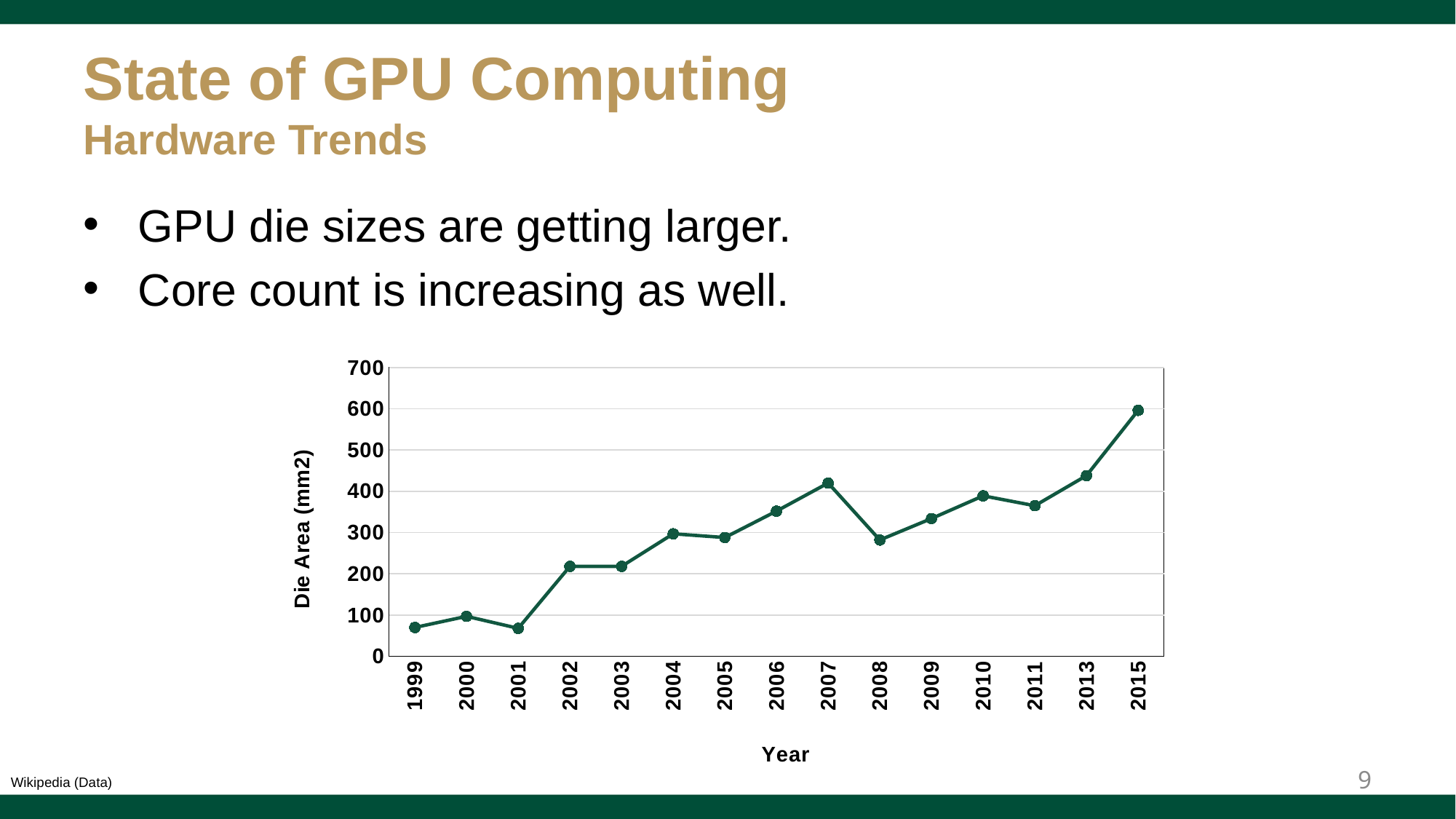
How many years are plotted on the x axis of the chart? 15 Is the die area for 2015 greater or less than 500? greater Which year has the highest die area in the chart? 2015 What kind of chart is shown on the slide? line chart Which year has the larger die area, 2007 or 2008? 2007 Is the die area for 2008 greater or less than 300? less Overall, does the die area rise or fall from 1999 to 2015? rise Is the die area for 2007 greater or less than 400? greater What is the label of the vertical axis of the chart? Die Area (mm2) Which year has the larger die area, 2001 or 2002? 2002